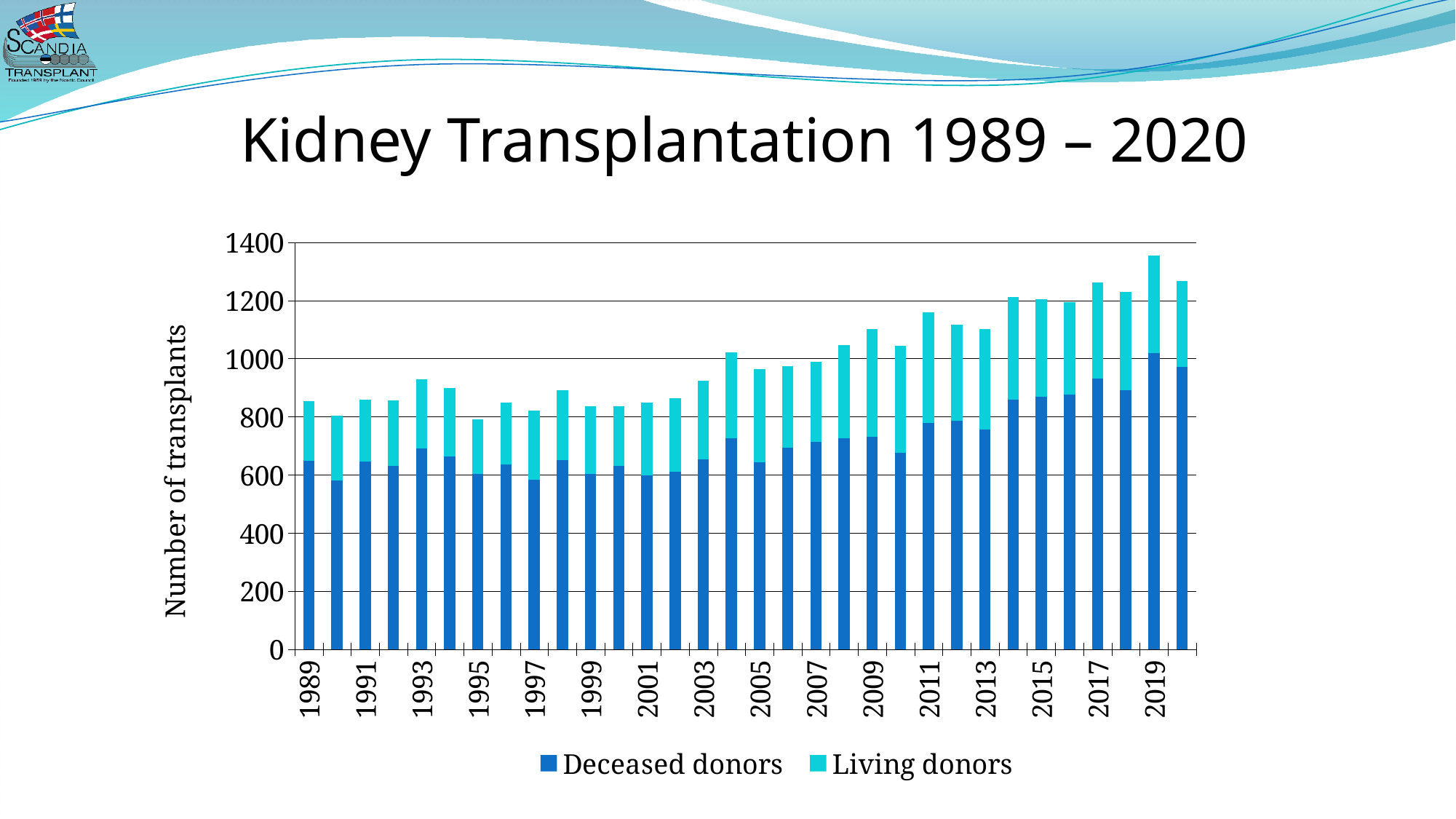
Which year has the larger total number of transplants, 2019 or 2020? 2019 How many years (bars) are plotted in the chart? 32 Is the total number of transplants in 1989 greater or less than 800? greater What are the two series named in the legend? Deceased donors and Living donors Is the number of deceased donor transplants in 2017 greater or less than 800? greater Is the number of deceased donor transplants in 2013 greater or less than 800? less What kind of chart is shown on the slide? Stacked bar chart Overall, do total transplants rise or fall from 1989 to 2020? rise Which year has the highest total number of transplants? 2019 How many series does the legend list? 2